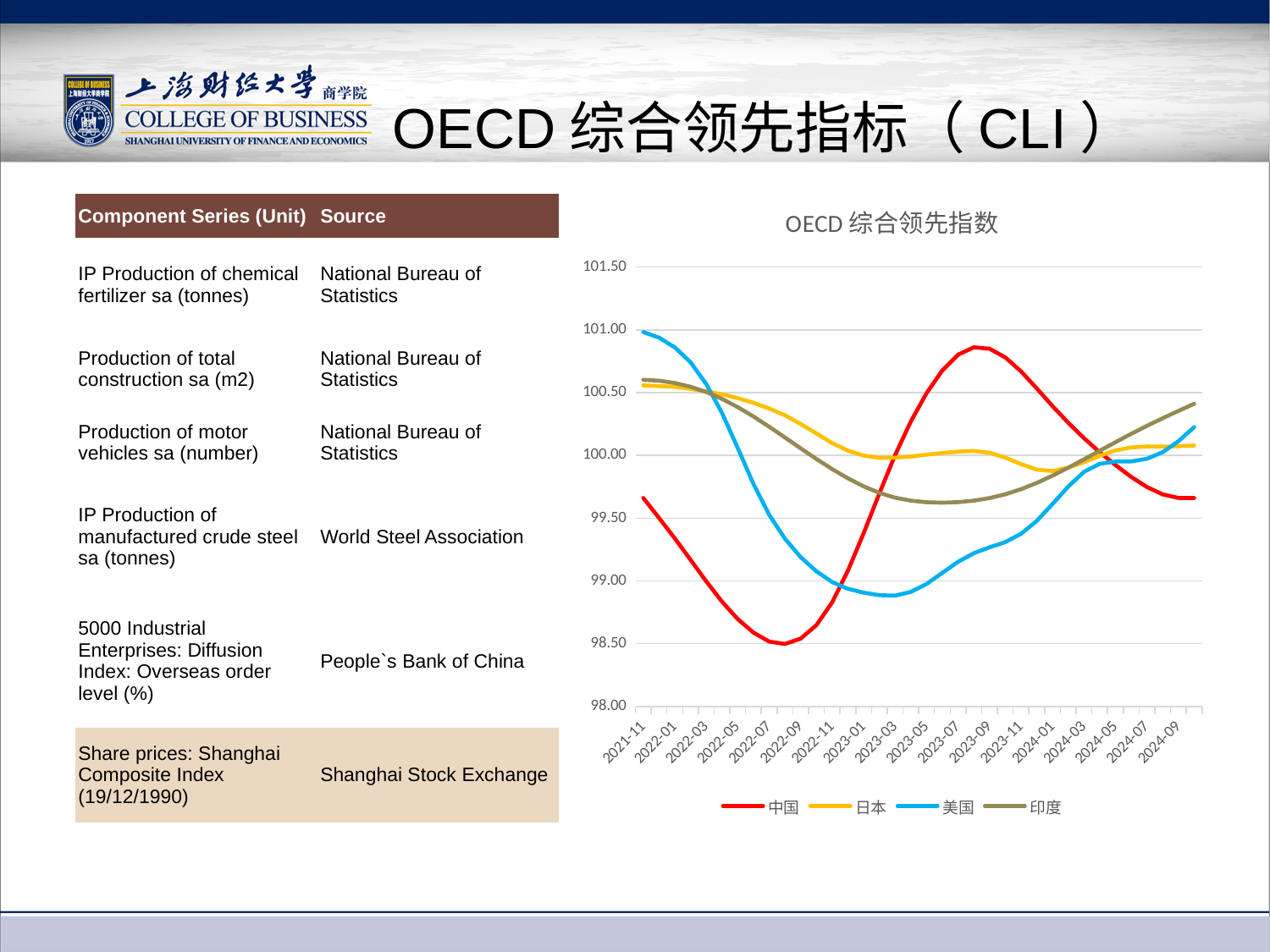
Is the value for 美国 at 2023-03 greater or less than 99.50? less What is the title of the chart? OECD 综合领先指数 Is the value for 美国 at 2021-11 greater or less than 100.50? greater How many series does the legend of the chart list? 4 At 2023-08, which is higher, 中国 or 美国? 中国 What kind of chart is shown on the slide? line chart Is the value for 中国 at 2022-08 greater or less than 99.00? less Does the 美国 series rise or fall from 2021-11 to 2023-03? fall Which colour is used for the 中国 series in the chart? red At 2021-11, which series has the highest value? 美国